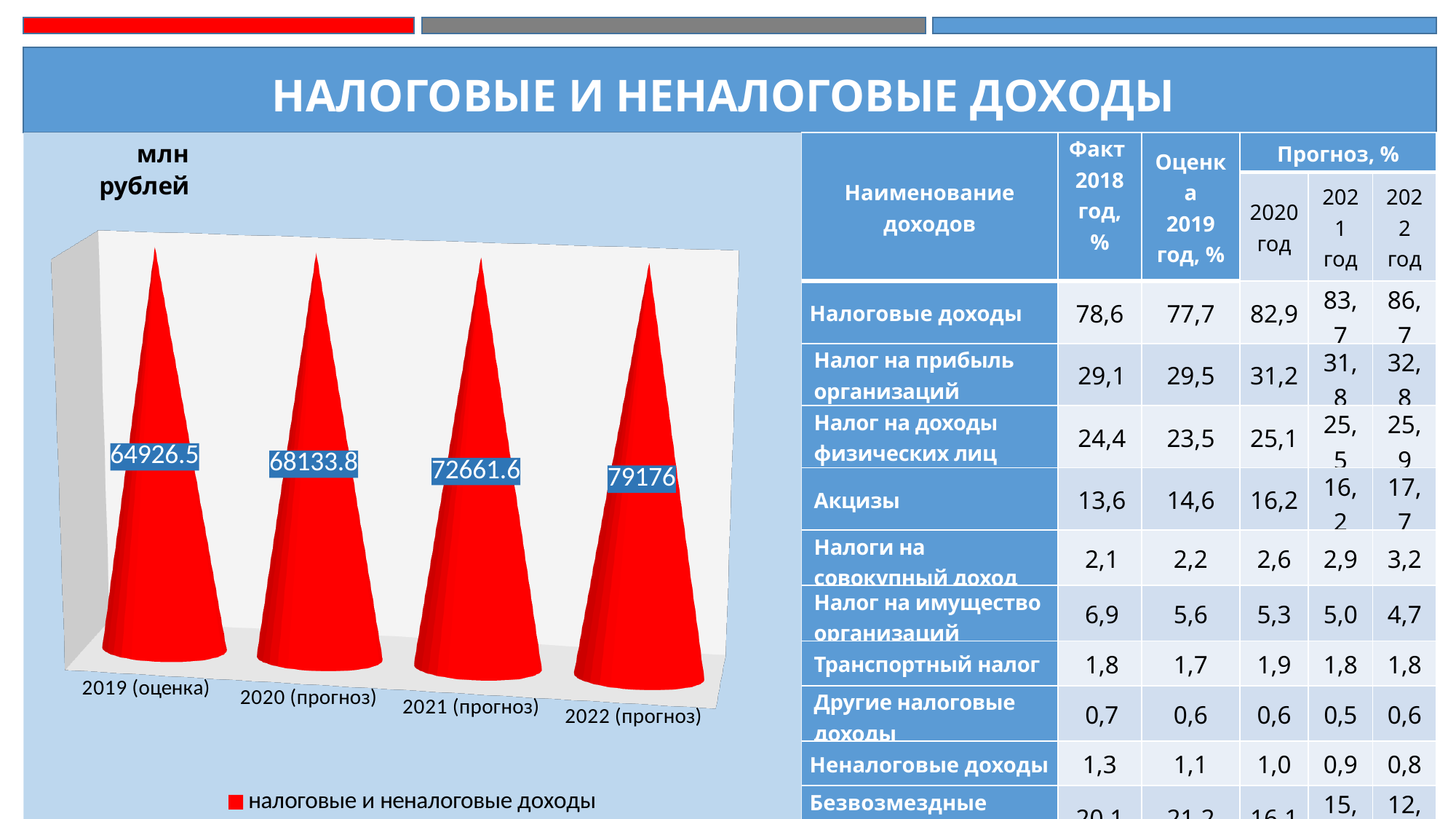
Do the values rise or fall from 2019 (оценка) to 2022 (прогноз) along the x axis? rise What is the difference between the values for 2020 (прогноз) and 2019 (оценка)? 3207.3 Which category has the highest value on the chart? 2022 (прогноз) What is the difference between the values for 2022 (прогноз) and 2021 (прогноз)? 6514.4 What is the value for 2021 (прогноз) on the chart? 72661.6 Which is larger: the value for 2021 (прогноз) or the value for 2020 (прогноз)? 2021 (прогноз) What series name does the chart legend show? налоговые и неналоговые доходы What is the value for 2020 (прогноз) on the chart? 68133.8 What is the value for 2022 (прогноз) on the chart? 79176 What is the value for 2019 (оценка) on the chart? 64926.5 Which category has the lowest value on the chart? 2019 (оценка) How many categories are plotted on the chart? 4